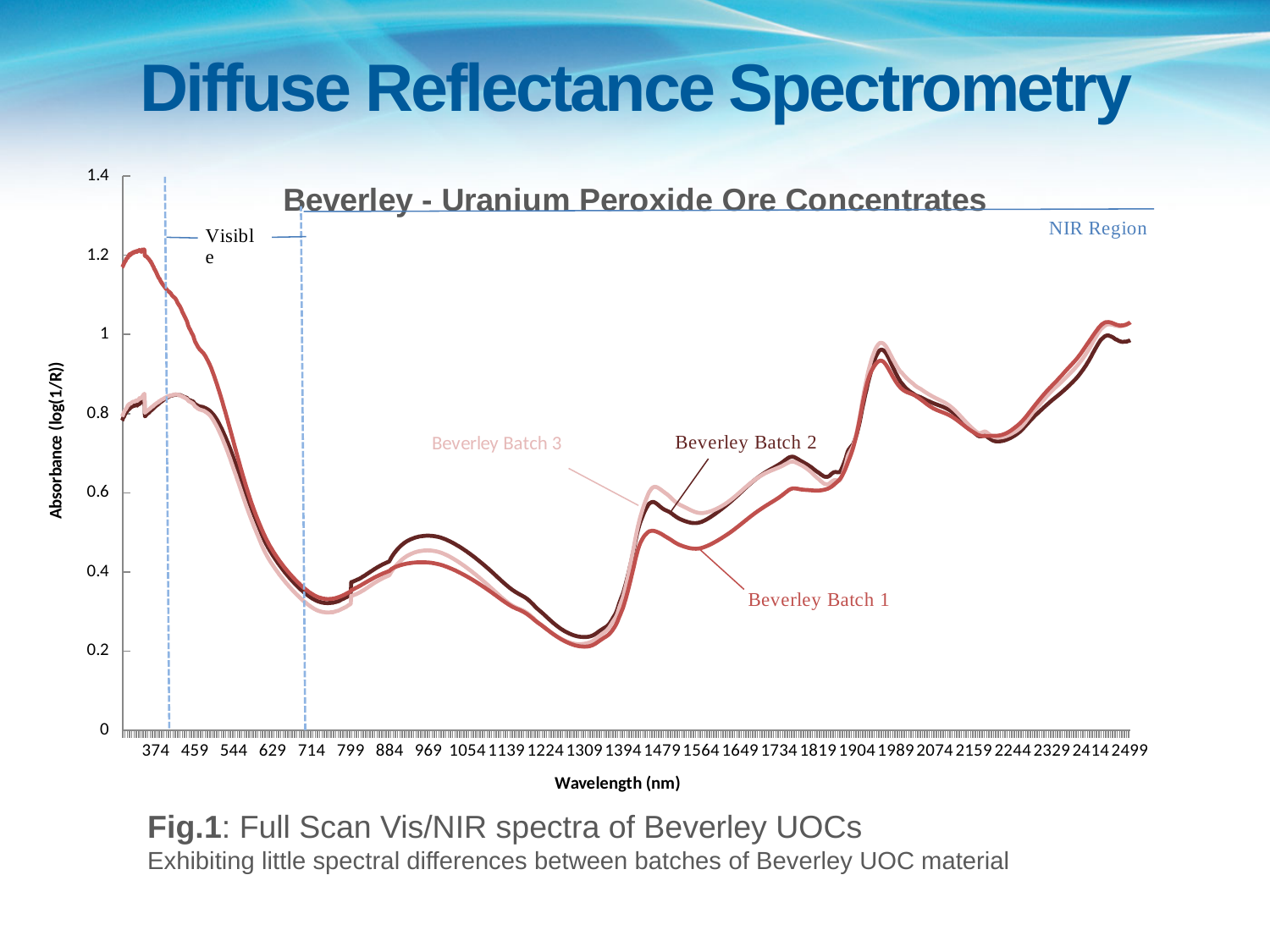
Is the absorbance of Beverley Batch 1 at 374 nm greater or less than 1? greater Which batch has the highest absorbance at 374 nm? Beverley Batch 1 What is the title of the chart? Beverley - Uranium Peroxide Ore Concentrates Do the absorbance values rise or fall between 459 nm and 714 nm? fall What kind of chart is shown on the slide? Line chart Is the absorbance of Beverley Batch 1 at 1564 nm greater or less than 0.6? less Is the absorbance of Beverley Batch 1 at 1989 nm greater or less than 0.8? greater What is the label of the y axis? Absorbance (log(1/R)) At 459 nm, which has the higher absorbance: Beverley Batch 1 or Beverley Batch 2? Beverley Batch 1 At 1564 nm, which has the higher absorbance: Beverley Batch 1 or Beverley Batch 2? Beverley Batch 2 How many batches (series) are plotted in the Beverley - Uranium Peroxide Ore Concentrates chart? 3